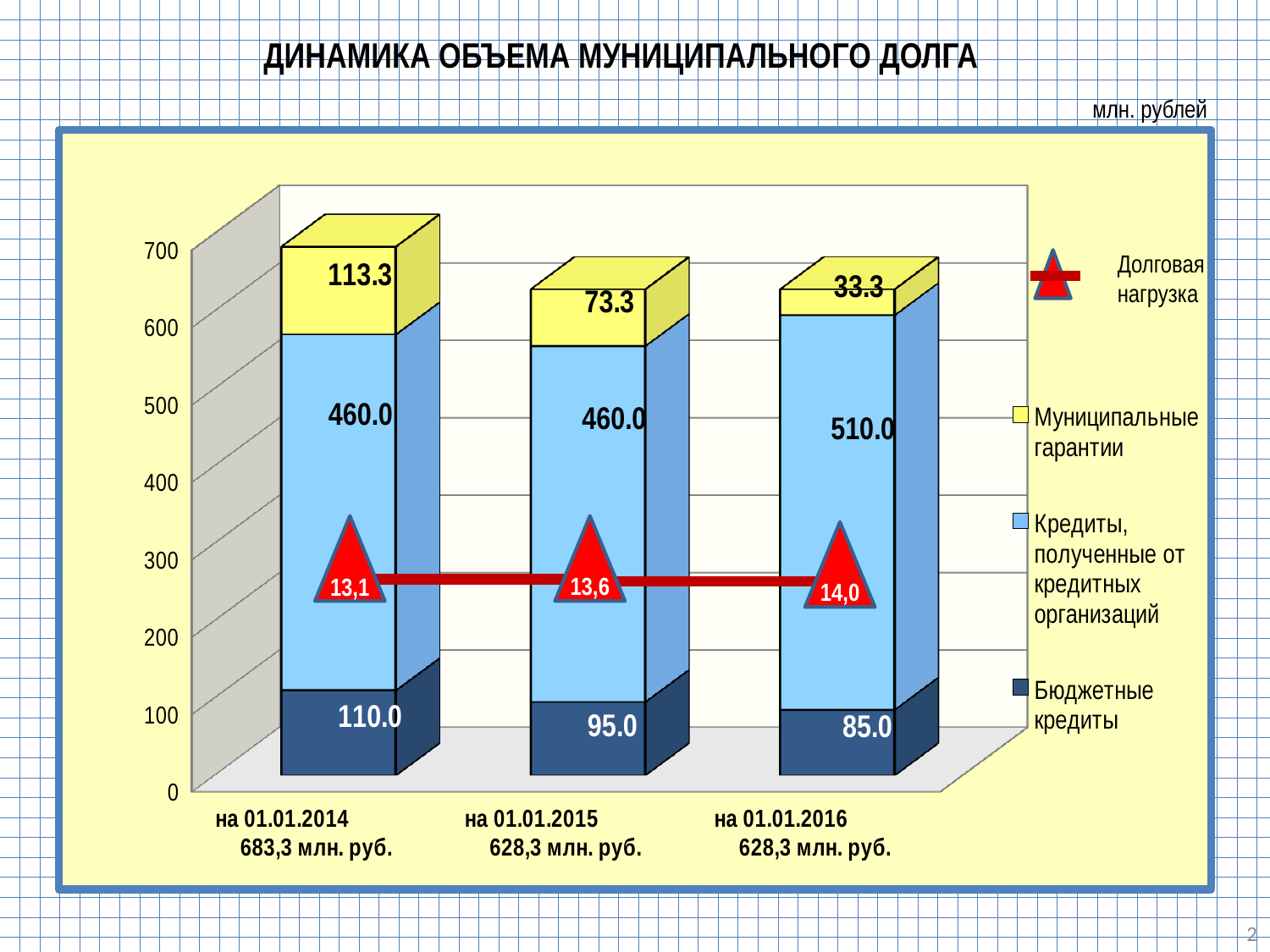
How many series does the legend list? 4 What is the total municipal debt shown for 01.01.2014? 683,3 млн. руб. On which date is Бюджетные кредиты the highest? на 01.01.2014 Does the Долговая нагрузка value rise or fall from 01.01.2014 to 01.01.2016? rise What is the value of Бюджетные кредиты on 01.01.2016? 85.0 What is the difference between Муниципальные гарантии on 01.01.2014 and on 01.01.2015? 40.0 What is the value of Кредиты, полученные от кредитных организаций on 01.01.2016? 510.0 On which date is Муниципальные гарантии the lowest? на 01.01.2016 What is the Долговая нагрузка value on 01.01.2015? 13,6 What is the value of Муниципальные гарантии on 01.01.2014? 113.3 How many dates (categories) are shown on the x axis? 3 Which is larger: Бюджетные кредиты on 01.01.2015 or on 01.01.2016? на 01.01.2015